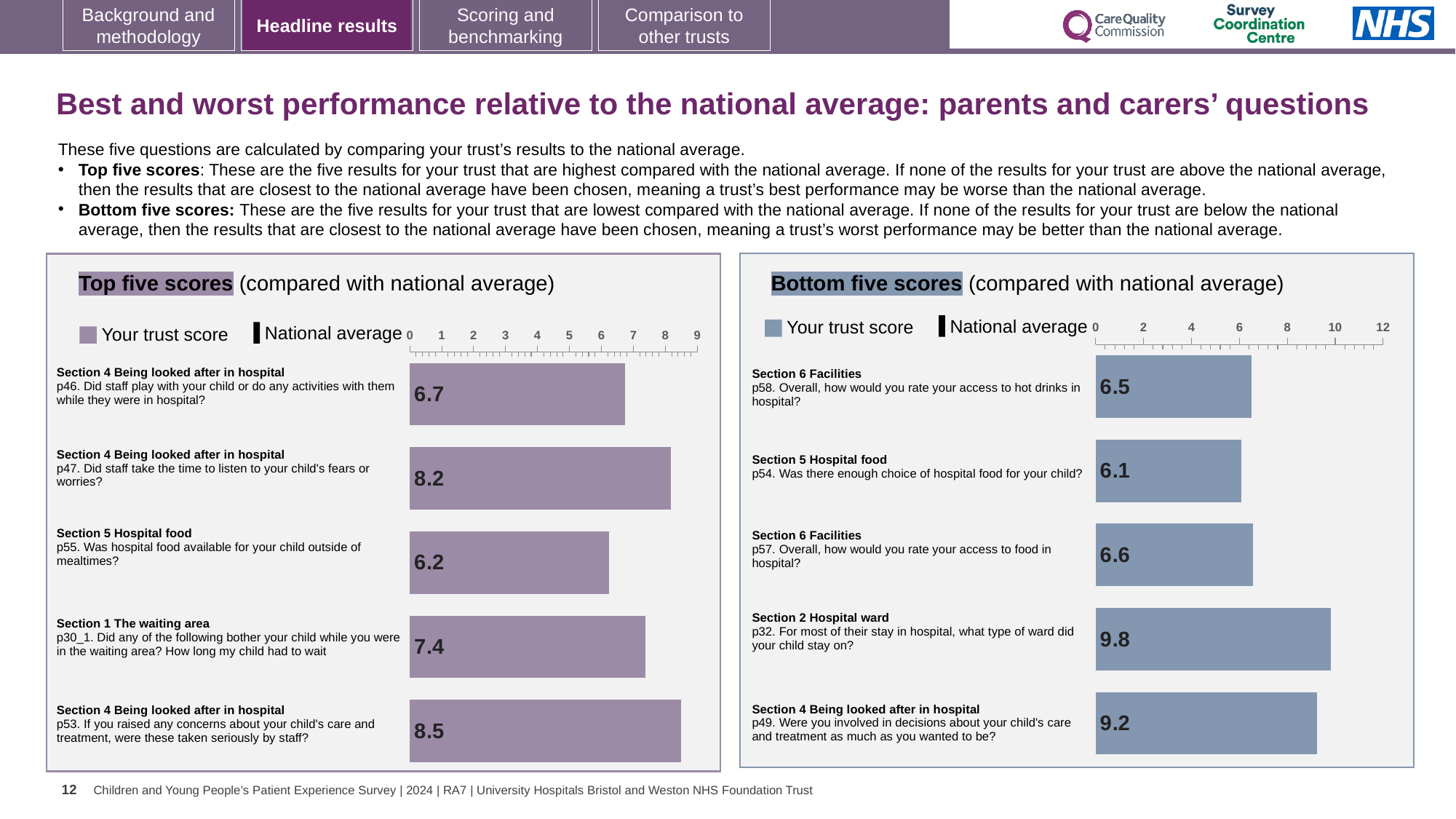
In the Bottom five scores chart, what is the difference between the trust scores for p32 and p54? 3.7 In the Bottom five scores chart, what is the trust score for p32 (For most of their stay in hospital, what type of ward did your child stay on)? 9.8 In the Bottom five scores chart, which question has the lowest trust score? p54. Was there enough choice of hospital food for your child? In the Top five scores chart, how many questions are plotted? 5 In the Bottom five scores chart, is the trust score for p49 greater or less than 8? greater In the Bottom five scores chart, which is larger: the trust score for p58 or for p57? p57 In the Top five scores chart, what is the difference between the trust scores for p53 and p46? 1.8 In the Top five scores chart, what is the trust score for p47 (Did staff take the time to listen to your child's fears or worries)? 8.2 In the Top five scores chart, which question has the lowest trust score? p55. Was hospital food available for your child outside of mealtimes? In the Top five scores chart, which question has the highest trust score? p53. If you raised any concerns about your child's care and treatment, were these taken seriously by staff? What type of chart is used in the Top five scores panel? Bar chart How many entries does the legend of the Bottom five scores chart list? 2